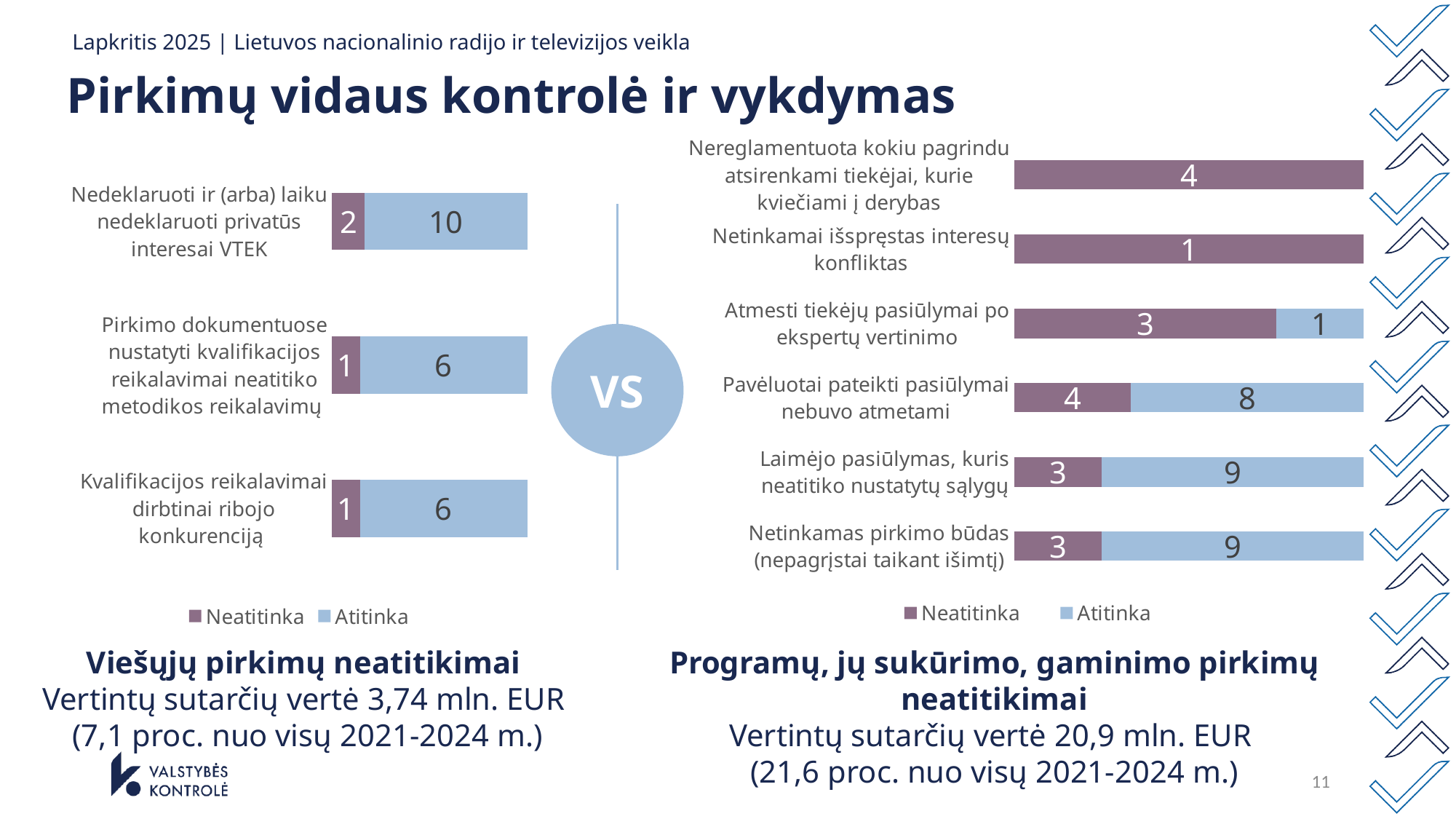
In the left chart (Viešųjų pirkimų neatitikimai), what is the Atitinka value for 'Nedeklaruoti ir (arba) laiku nedeklaruoti privatūs interesai VTEK'? 10 In the right chart (Programų, jų sukūrimo, gaminimo pirkimų neatitikimai), how many categories are shown? 6 In the right chart (Programų, jų sukūrimo, gaminimo pirkimų neatitikimai), what is the total of the stacked bar for 'Netinkamas pirkimo būdas (nepagrįstai taikant išimtį)'? 12 In the right chart (Programų, jų sukūrimo, gaminimo pirkimų neatitikimai), what is the difference between the Atitinka and Neatitinka values for 'Pavėluotai pateikti pasiūlymai nebuvo atmetami'? 4 In the left chart (Viešųjų pirkimų neatitikimai), how many categories are shown? 3 In the left chart (Viešųjų pirkimų neatitikimai), what is the total of the stacked bar for 'Nedeklaruoti ir (arba) laiku nedeklaruoti privatūs interesai VTEK'? 12 In the right chart (Programų, jų sukūrimo, gaminimo pirkimų neatitikimai), what is the Atitinka value for 'Laimėjo pasiūlymas, kuris neatitiko nustatytų sąlygų'? 9 In the left chart (Viešųjų pirkimų neatitikimai), what is the Neatitinka value for 'Kvalifikacijos reikalavimai dirbtinai ribojo konkurenciją'? 1 What type of chart is the left chart (Viešųjų pirkimų neatitikimai)? Stacked bar chart How many series does the legend of the right chart (Programų, jų sukūrimo, gaminimo pirkimų neatitikimai) list? 2 In the right chart (Programų, jų sukūrimo, gaminimo pirkimų neatitikimai), what is the Neatitinka value for 'Pavėluotai pateikti pasiūlymai nebuvo atmetami'? 4 In the right chart (Programų, jų sukūrimo, gaminimo pirkimų neatitikimai), what is the Neatitinka value for 'Netinkamai išspręstas interesų konfliktas'? 1